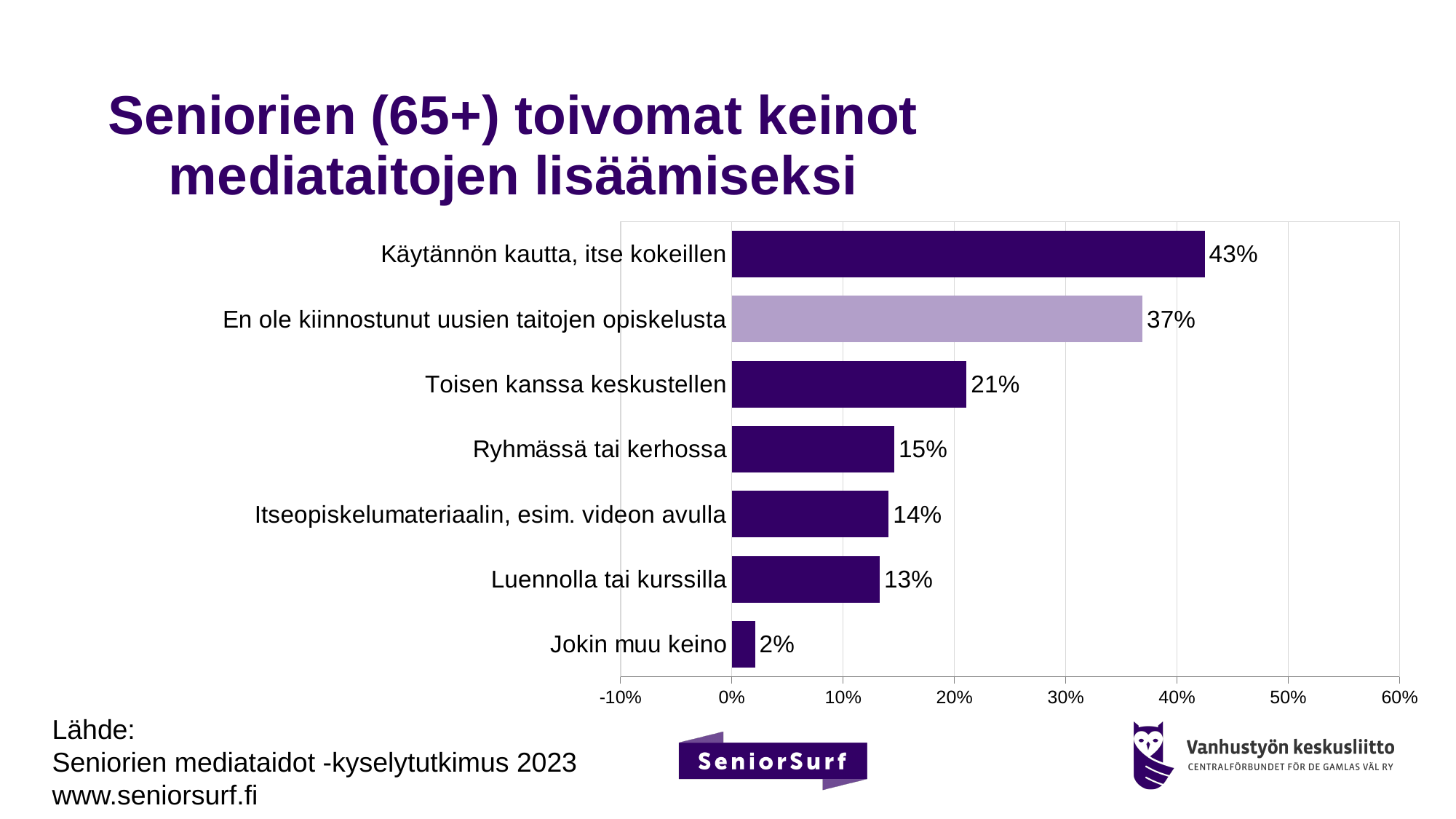
Which bar is shown in a lighter colour than the others? En ole kiinnostunut uusien taitojen opiskelusta How many categories are shown in the chart? 7 Which is larger: "Ryhmässä tai kerhossa" or "Itseopiskelumateriaalin, esim. videon avulla"? Ryhmässä tai kerhossa Which category has the highest value? Käytännön kautta, itse kokeillen What is the value for "Toisen kanssa keskustellen"? 21% What kind of chart is shown on the slide? bar chart Which category has the lowest value? Jokin muu keino What is the value for "Käytännön kautta, itse kokeillen"? 43% What is the value for "Luennolla tai kurssilla"? 13% What is the difference between "Toisen kanssa keskustellen" and "Jokin muu keino"? 19% What is the difference between "Käytännön kautta, itse kokeillen" and "En ole kiinnostunut uusien taitojen opiskelusta"? 6% Is the value for "En ole kiinnostunut uusien taitojen opiskelusta" greater or less than 30%? greater